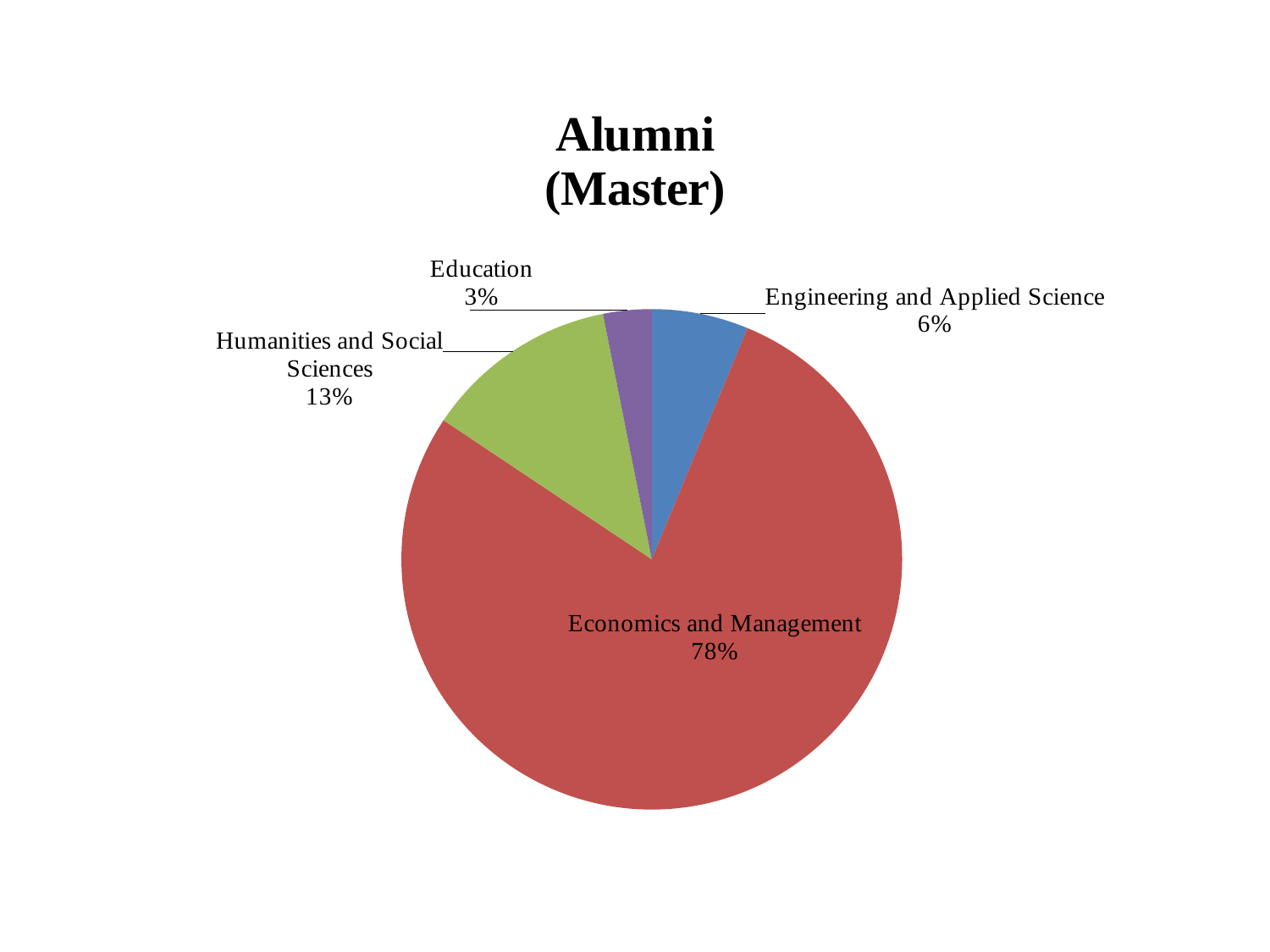
What is the difference in percentage points between Humanities and Social Sciences and Engineering and Applied Science? 7 What is the title of the chart? Alumni (Master) What kind of chart is shown on the slide? Pie chart What percentage is shown for Humanities and Social Sciences? 13% How many categories are shown in the pie chart? 4 What share of the pie does Economics and Management hold? 78% Which category has the largest slice of the pie? Economics and Management Which is larger, the share for Engineering and Applied Science or the share for Education? Engineering and Applied Science Which category has the smallest slice of the pie? Education What percentage is shown for Engineering and Applied Science? 6% What percentage is shown for Education? 3% What colour is the Economics and Management slice? Red